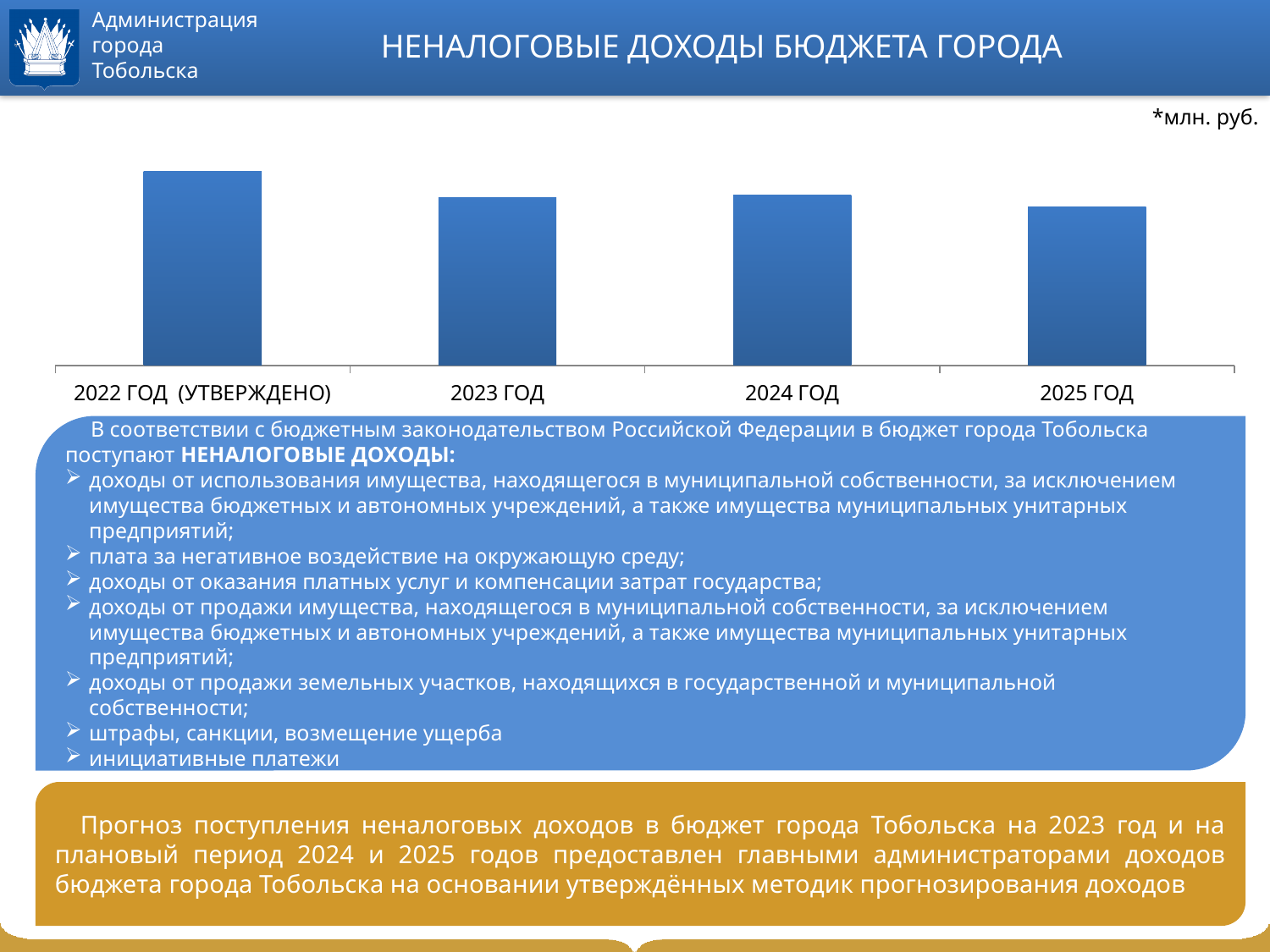
In what units are the chart values given, according to the note on the slide? млн. руб. Which category has the lowest bar? 2025 ГОД How many bars (categories) does the chart show? 4 Which is larger, the value for 2022 ГОД (УТВЕРЖДЕНО) or for 2023 ГОД? 2022 ГОД (УТВЕРЖДЕНО) Do the values generally rise or fall from 2022 to 2025 along the x axis? fall Which is larger, the value for 2024 ГОД or for 2025 ГОД? 2024 ГОД What is the title of the slide containing the chart? НЕНАЛОГОВЫЕ ДОХОДЫ БЮДЖЕТА ГОРОДА What kind of chart is shown on the slide? bar chart Which is larger, the value for 2022 ГОД (УТВЕРЖДЕНО) or for 2025 ГОД? 2022 ГОД (УТВЕРЖДЕНО) Which category has the highest bar? 2022 ГОД (УТВЕРЖДЕНО)